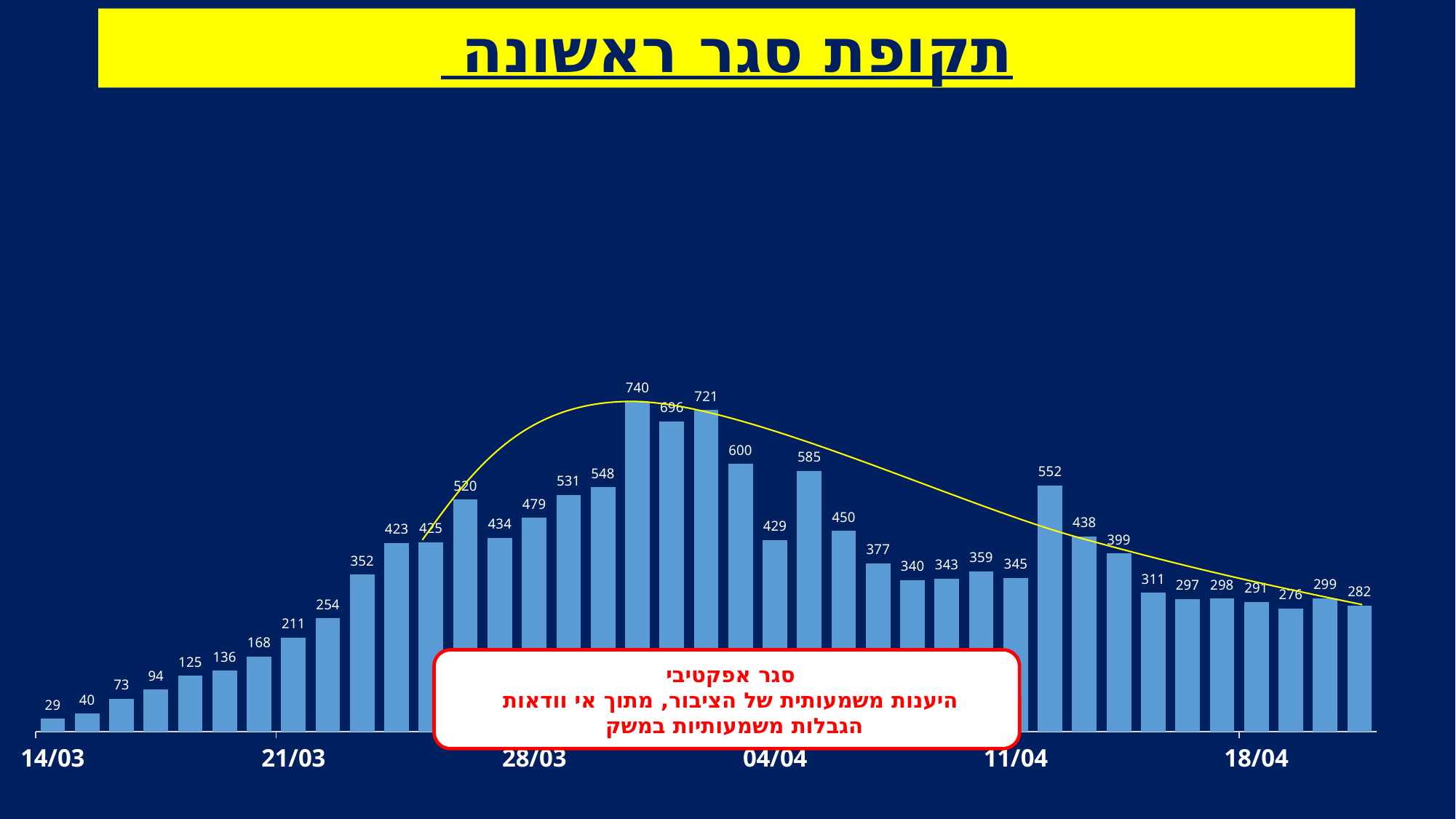
What is the value of the bar at 18/04? 291 What kind of chart is shown on the slide? combination bar and line chart Do the values rise or fall between 14/03 and 21/03? rise What colour are the bars on the chart? light blue What is the value of the bar at 21/03? 211 What is the difference between the highest bar (740) and the bar labelled 721? 19 Which is larger, the bar at 21/03 or the bar at 18/04? 18/04 What is the value of the bar at 11/04? 345 How many bars are plotted on the chart? 39 What is the highest value shown on the chart? 740 What is the value of the bar at 14/03? 29 What is the lowest value shown on the chart? 29